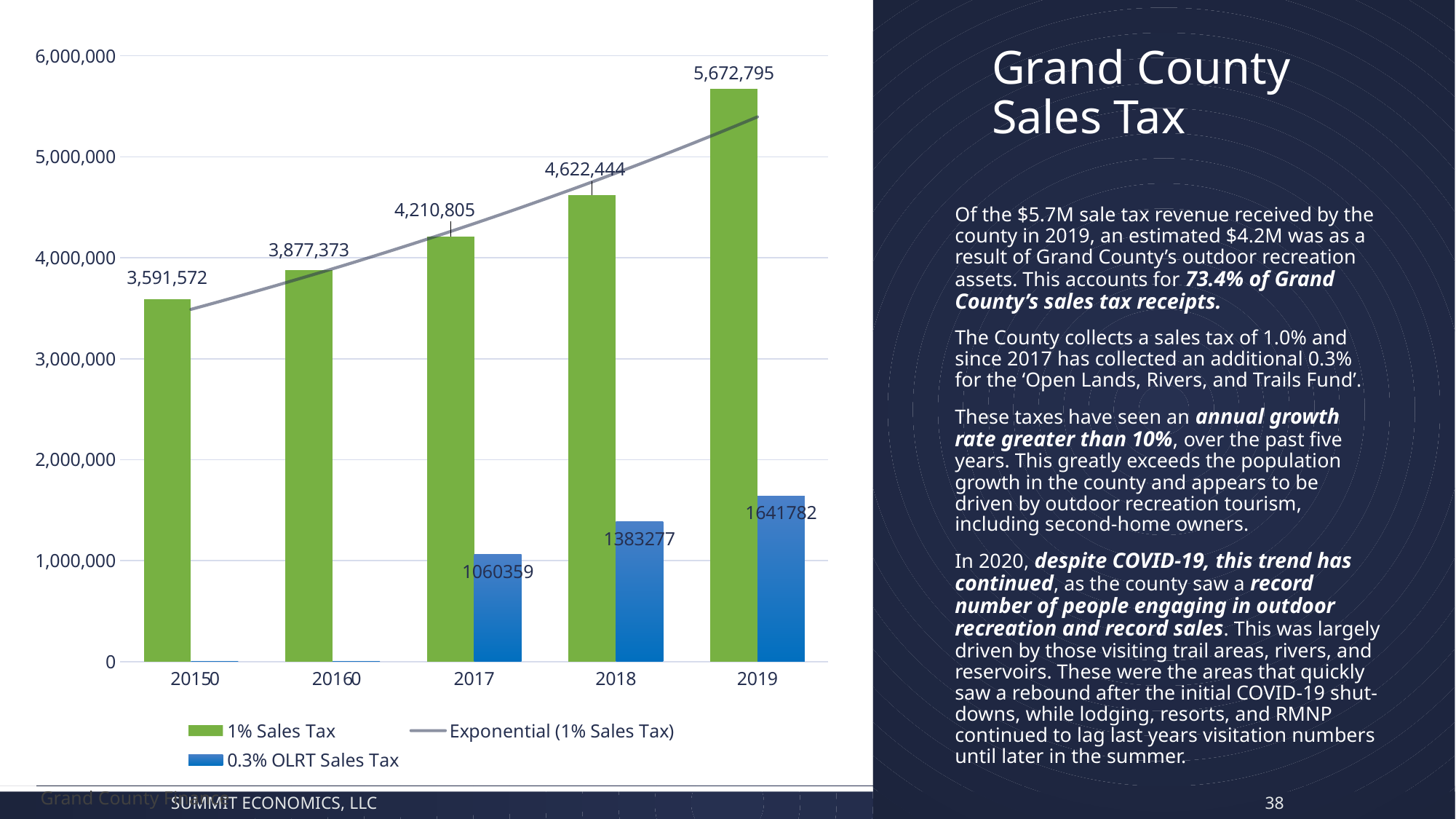
Do the 1% Sales Tax values rise or fall from left to right along the x axis? rise What is the difference between the 1% Sales Tax values for 2019 and 2018? 1,050,351 Which year has the highest 1% Sales Tax value? 2019 Which is larger: the 0.3% OLRT Sales Tax for 2019 or for 2017? 2019 How many entries does the legend list? 3 What is the value of the 1% Sales Tax bar for 2019? 5,672,795 Is the 1% Sales Tax value for 2018 greater or less than 4,000,000? greater Which year has the lowest 0.3% OLRT Sales Tax value among the years with a labelled blue bar? 2017 How many categories are shown on the x axis? 5 What kind of chart is shown on the slide? bar chart What is the value of the 1% Sales Tax bar for 2017? 4,210,805 What is the value of the 0.3% OLRT Sales Tax bar for 2018? 1383277